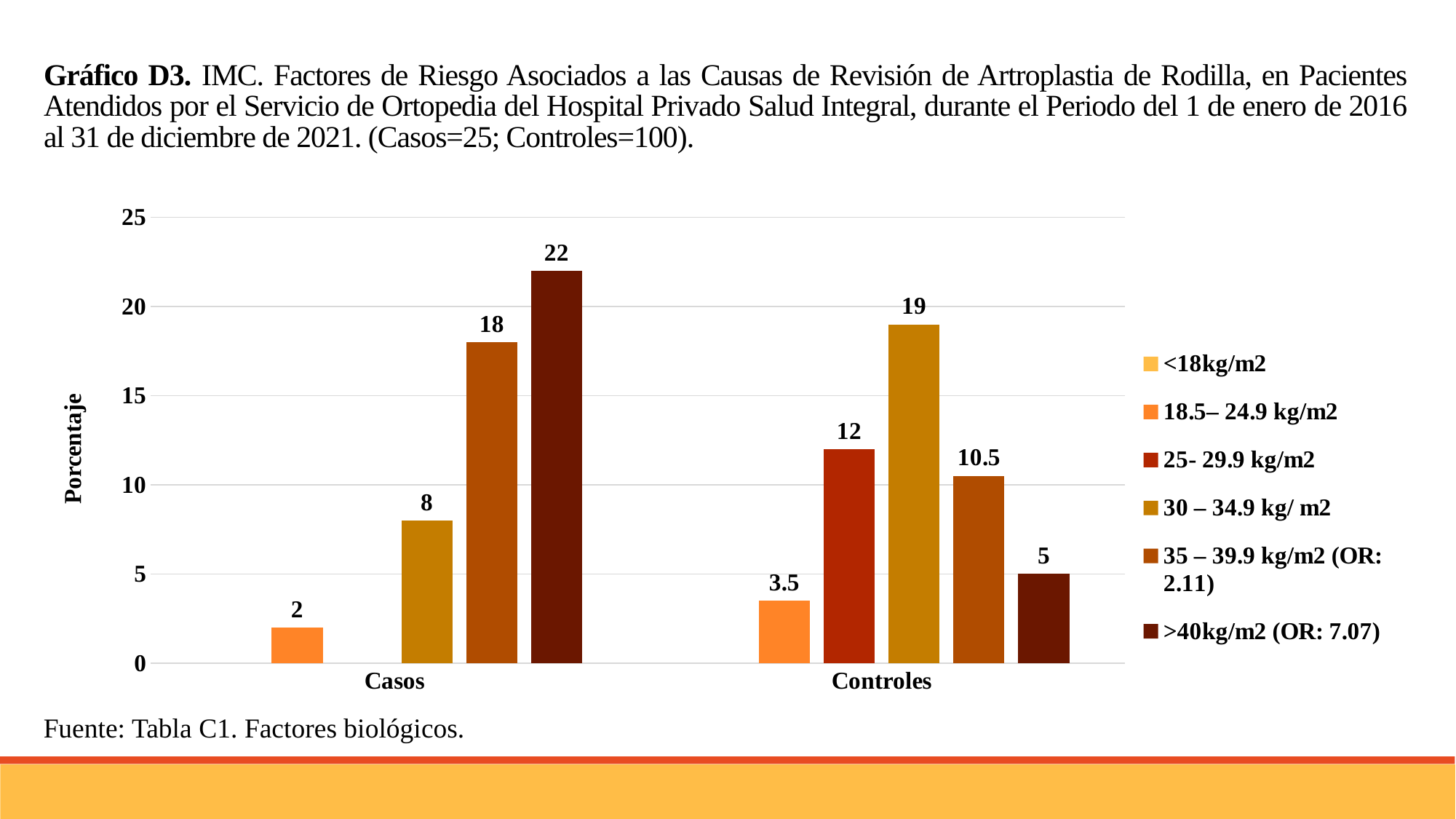
Which series has the lowest value in the Controles group? 18.5– 24.9 kg/m2 How many category groups are shown on the x axis? 2 What is the label of the vertical axis? Porcentaje Which series has the highest value in the Casos group? >40kg/m2 (OR: 7.07) What kind of chart is shown on the slide? Bar chart What is the difference between the >40kg/m2 value for Casos and for Controles? 17 What is the value for the 30 – 34.9 kg/ m2 series in the Controles group? 19 Which is larger: the 35 – 39.9 kg/m2 value for Casos or for Controles? Casos What is the value for the 35 – 39.9 kg/m2 (OR: 2.11) series in the Casos group? 18 What is the value for the >40kg/m2 (OR: 7.07) series in the Controles group? 5 How many series does the legend list? 6 What is the value for the 18.5– 24.9 kg/m2 series in the Casos group? 2